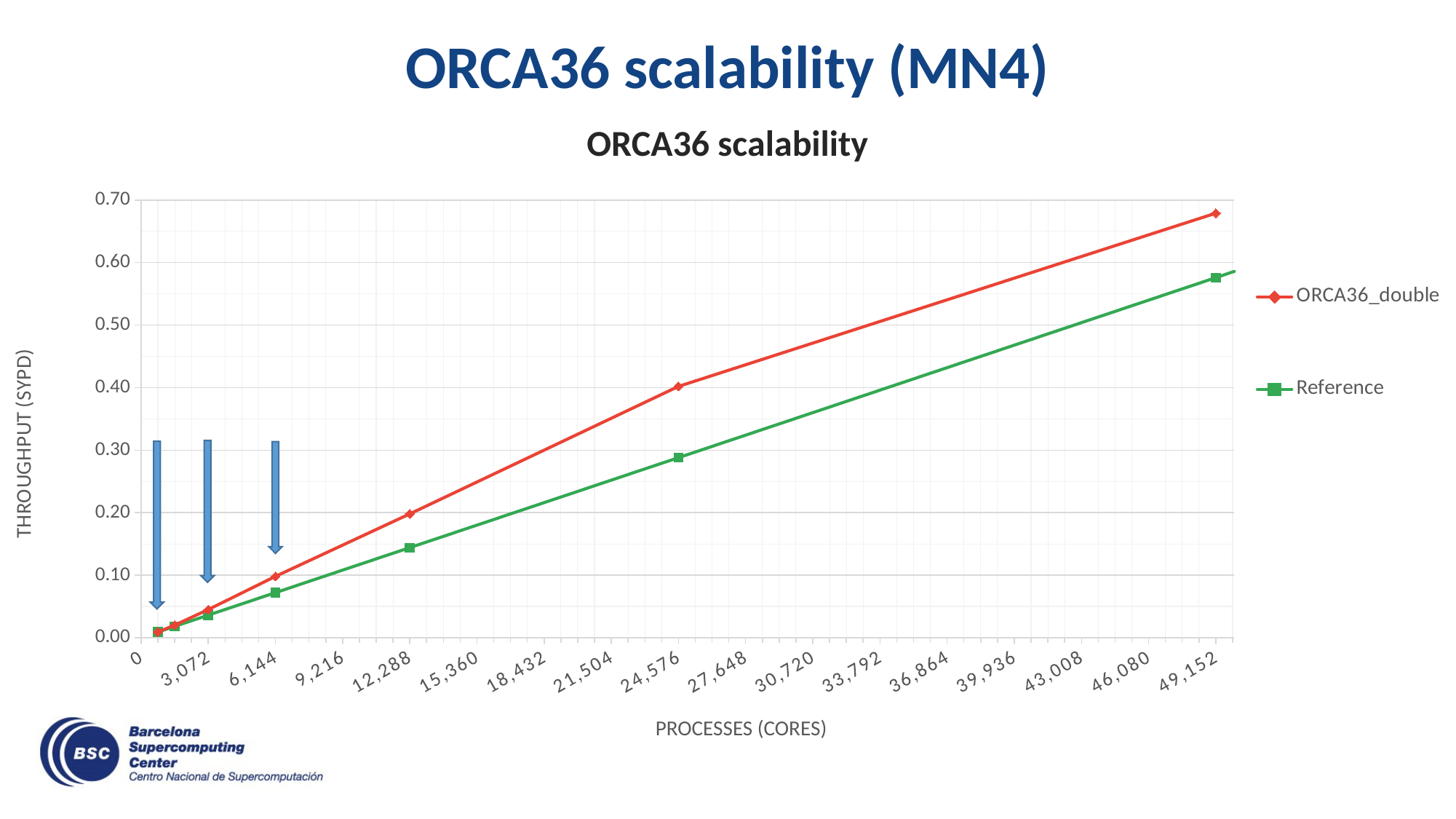
Does the throughput of the ORCA36_double series rise or fall as the number of processes increases? Rises Is the throughput of ORCA36_double at 49,152 processes greater or less than 0.60? greater What is the label of the y axis? THROUGHPUT (SYPD) What colour is the Reference series line? Green Is the throughput of Reference at 12,288 processes greater or less than 0.20? less How many series does the legend list? 2 Is the throughput of ORCA36_double at 24,576 processes greater or less than 0.30? greater Which series has the higher throughput at 24,576 processes? ORCA36_double Which series has the higher throughput at 49,152 processes? ORCA36_double What kind of chart is shown on the slide? Line chart